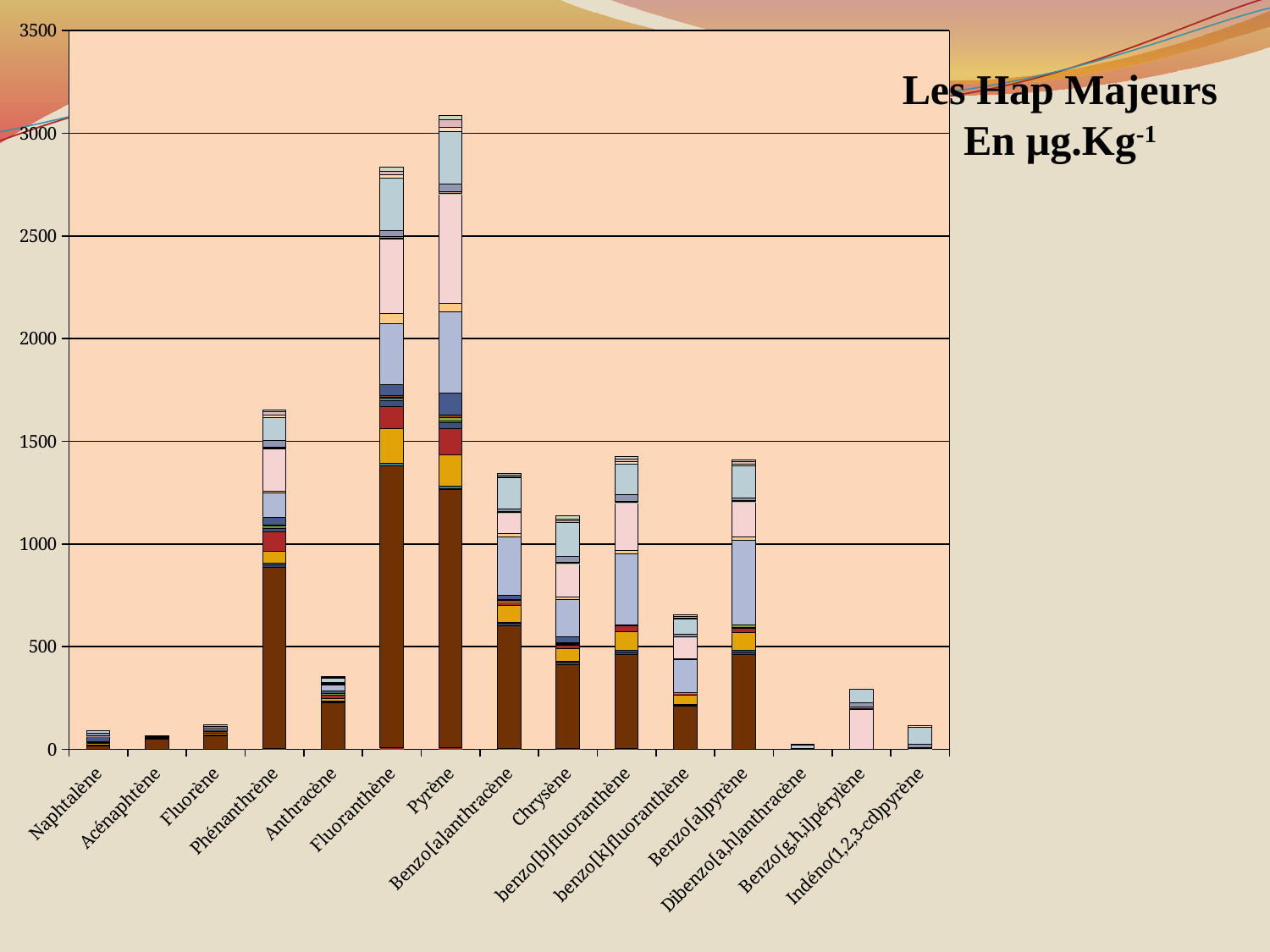
Which has the taller stacked bar, Phénanthrène or Benzo[a]anthracène? Phénanthrène Is the total stacked value for Chrysène greater or less than 1000? greater Is the total stacked value for Phénanthrène greater or less than 1500? greater Which category has the shortest stacked bar? Dibenzo[a,h]anthracène Is the total stacked value for Anthracène greater or less than 500? less Which category has the tallest stacked bar? Pyrène What is the title shown next to the chart? Les Hap Majeurs En µg.Kg-1 Which has the taller stacked bar, Chrysène or benzo[k]fluoranthène? Chrysène What kind of chart is shown on the slide? Stacked bar chart How many categories are shown along the x axis of the chart? 15